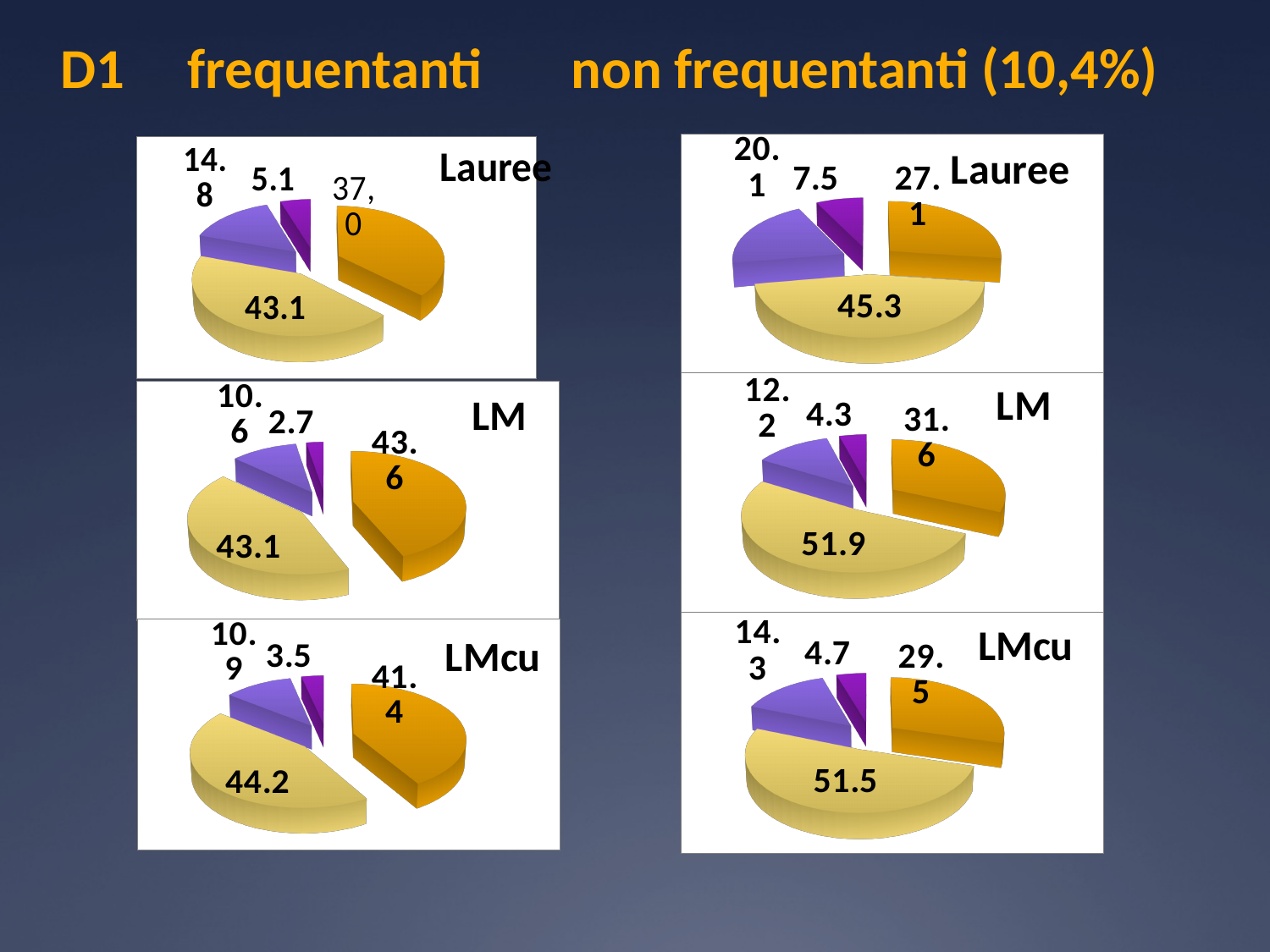
In the 'LM' pie chart under 'frequentanti' (middle left), what is the value of the smallest slice? 2.7 In the 'LM' pie chart under 'non frequentanti' (middle right), what is the value of the light yellow slice? 51.9 How many slices does each pie chart on the slide have? 4 In the 'Lauree' pie chart under 'non frequentanti' (top right), which is larger: the light yellow slice or the orange slice? The light yellow slice In the 'Lauree' pie chart under 'frequentanti' (top left), what is the value of the largest slice? 43.1 In the 'LM' pie chart under 'non frequentanti' (middle right), what is the value of the smallest slice? 4.3 What kind of charts are shown on the slide? Pie charts How many pie charts are on the slide? 6 In the 'LMcu' pie chart under 'frequentanti' (bottom left), what is the value of the orange slice? 41.4 In the 'Lauree' pie chart under 'non frequentanti' (top right), what is the value of the orange slice? 27.1 In the 'LMcu' pie chart under 'non frequentanti' (bottom right), what is the difference between the light yellow slice (51.5) and the orange slice (29.5)? 22.0 In the 'LMcu' pie chart under 'non frequentanti' (bottom right), what is the value of the largest slice? 51.5